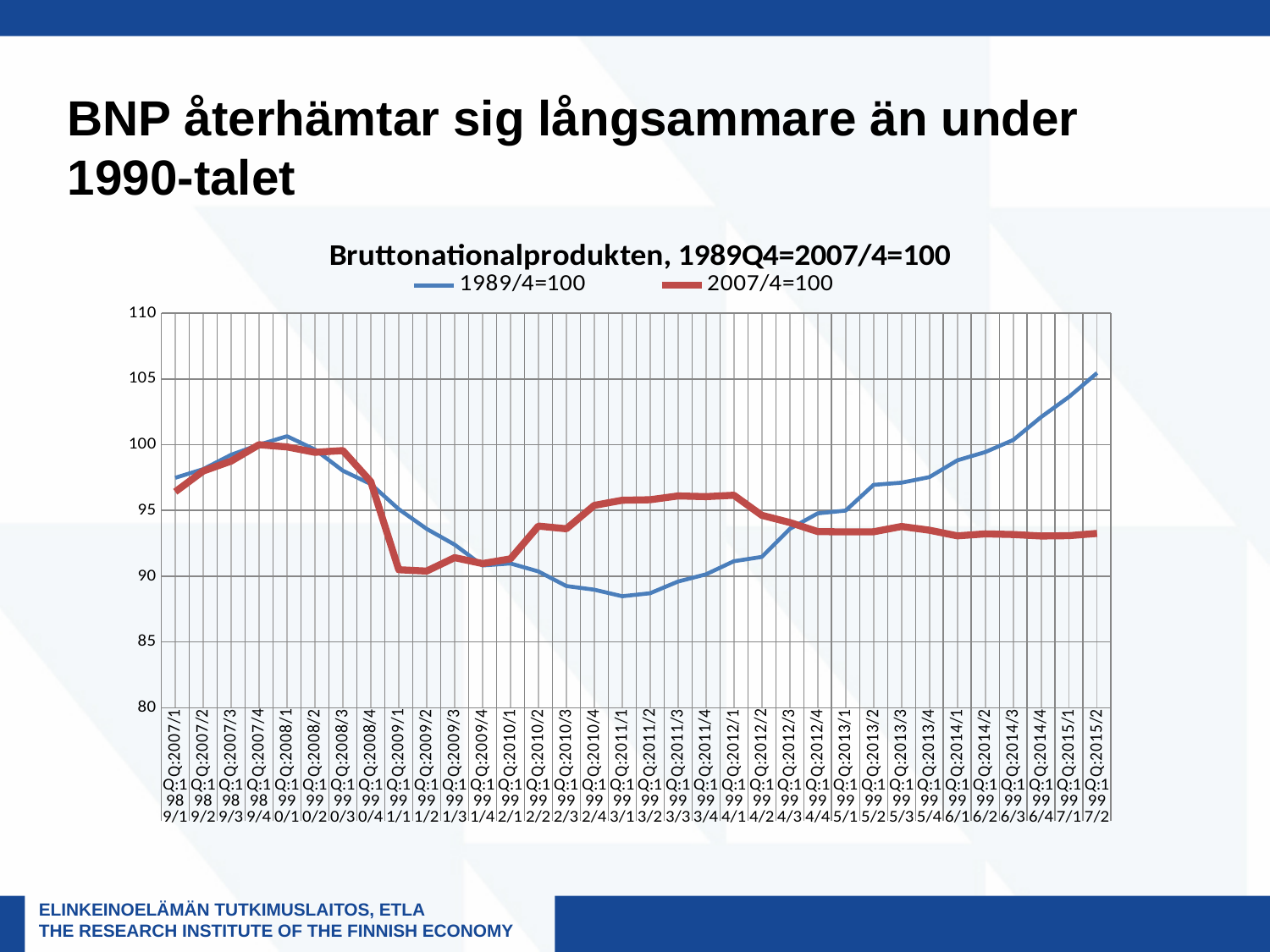
How many quarters are plotted along the x axis (from Q:2007/1 to Q:2015/2)? 34 At Q:2015/2, which series has the higher value, 1989/4=100 or 2007/4=100? 1989/4=100 What is the title of the chart? Bruttonationalprodukten, 1989Q4=2007/4=100 Is the value of the 2007/4=100 series at Q:2015/2 greater or less than 95? less What colour is the line for the 2007/4=100 series? Red At Q:2011/1, which series has the higher value, 1989/4=100 or 2007/4=100? 2007/4=100 What kind of chart is shown on the slide? Line chart How many series does the chart legend list? 2 Is the value of the 1989/4=100 series at Q:2015/2 greater or less than 100? greater Is the value of the 1989/4=100 series at Q:2011/1 greater or less than 90? less Does the 1989/4=100 series rise or fall between Q:2011/1 and Q:2015/2? Rises